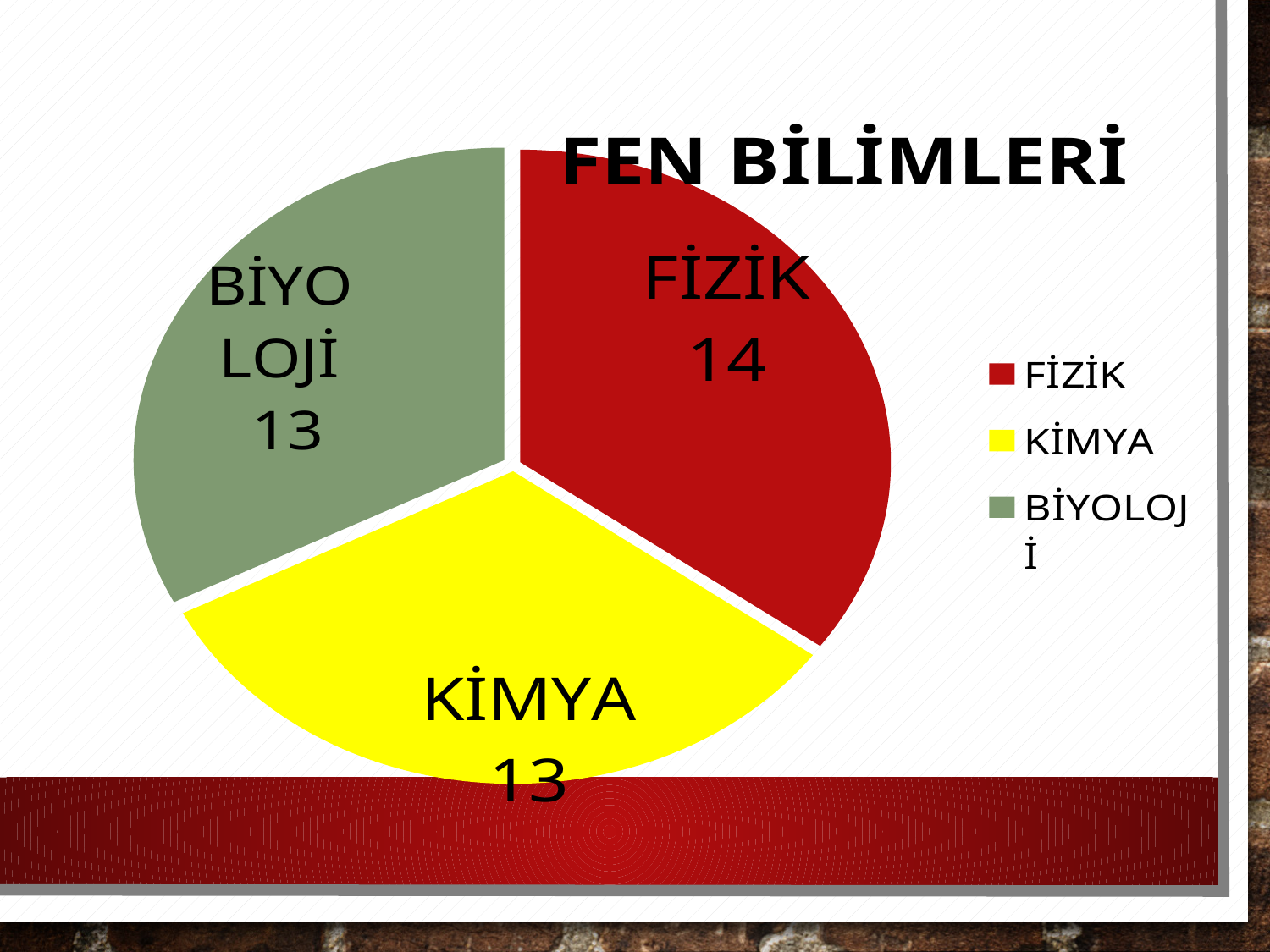
Which category has the largest slice of the pie? FİZİK How many entries does the legend list? 3 What is the title of the chart? FEN BİLİMLERİ What kind of chart is shown on the slide? Pie chart Which is larger, the value for FİZİK or the value for BİYOLOJİ? FİZİK What is the difference between the FİZİK value and the KİMYA value? 1 What value is shown for the FİZİK slice? 14 What colour is the KİMYA slice? Yellow What value is shown for the KİMYA slice? 13 What value is shown for the BİYOLOJİ slice? 13 How many slices does the pie chart have? 3 What is the total of all the slice values in the pie chart? 40